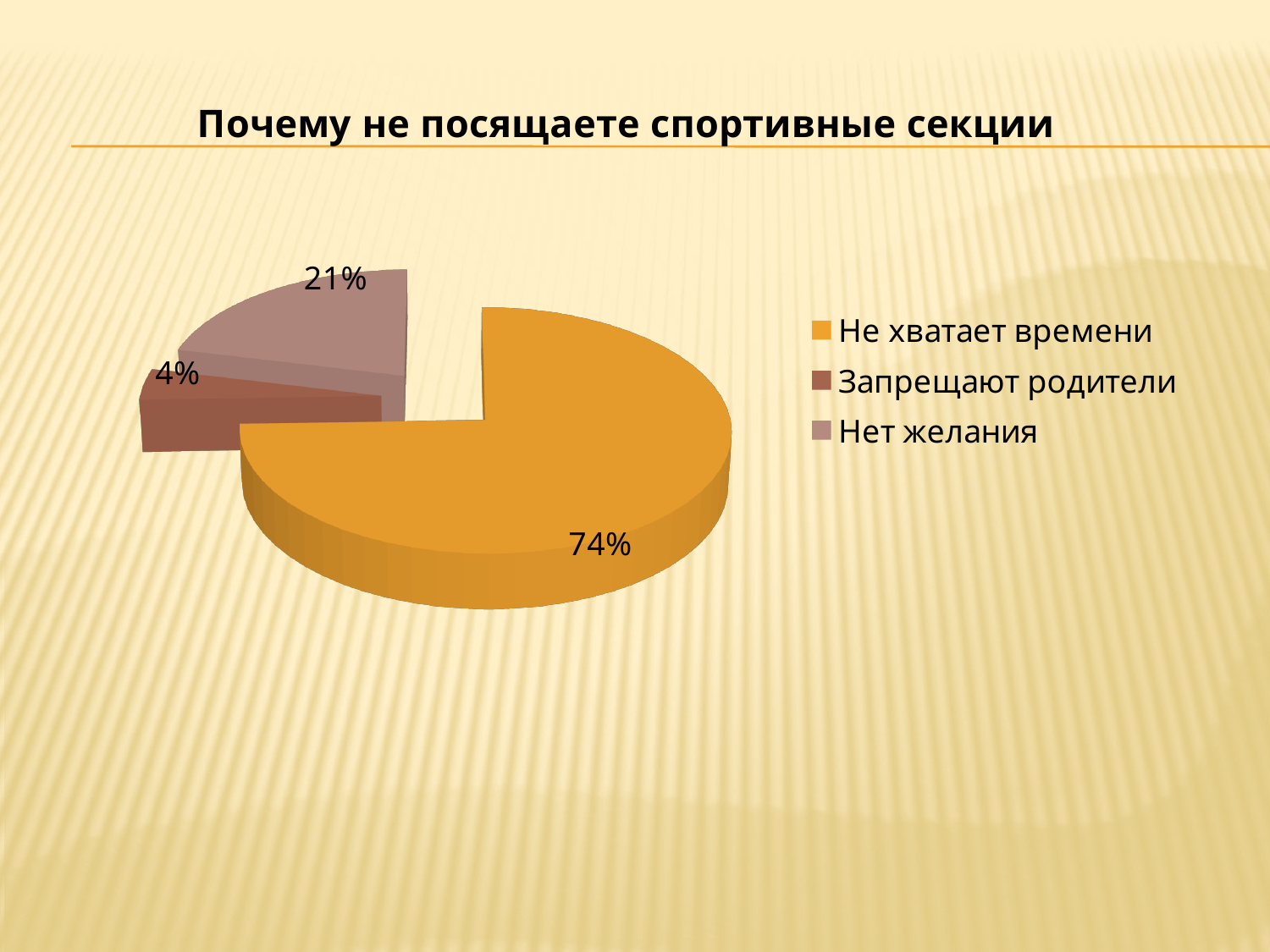
Which is larger: the slice for "Нет желания" or the slice for "Запрещают родители"? Нет желания Which category has the largest slice of the pie? Не хватает времени Which category has the smallest slice of the pie? Запрещают родители What is the title of the chart? Почему не посящаете спортивные секции What share of the pie does "Запрещают родители" take? 4% What type of chart is shown on the slide? pie chart How many categories does the pie chart have? 3 What colour is the slice for "Не хватает времени"? orange What is the difference in percentage points between "Нет желания" and "Запрещают родители"? 17 What share of the pie does "Не хватает времени" take? 74% What share of the pie does "Нет желания" take? 21% What is the difference in percentage points between "Не хватает времени" and "Нет желания"? 53